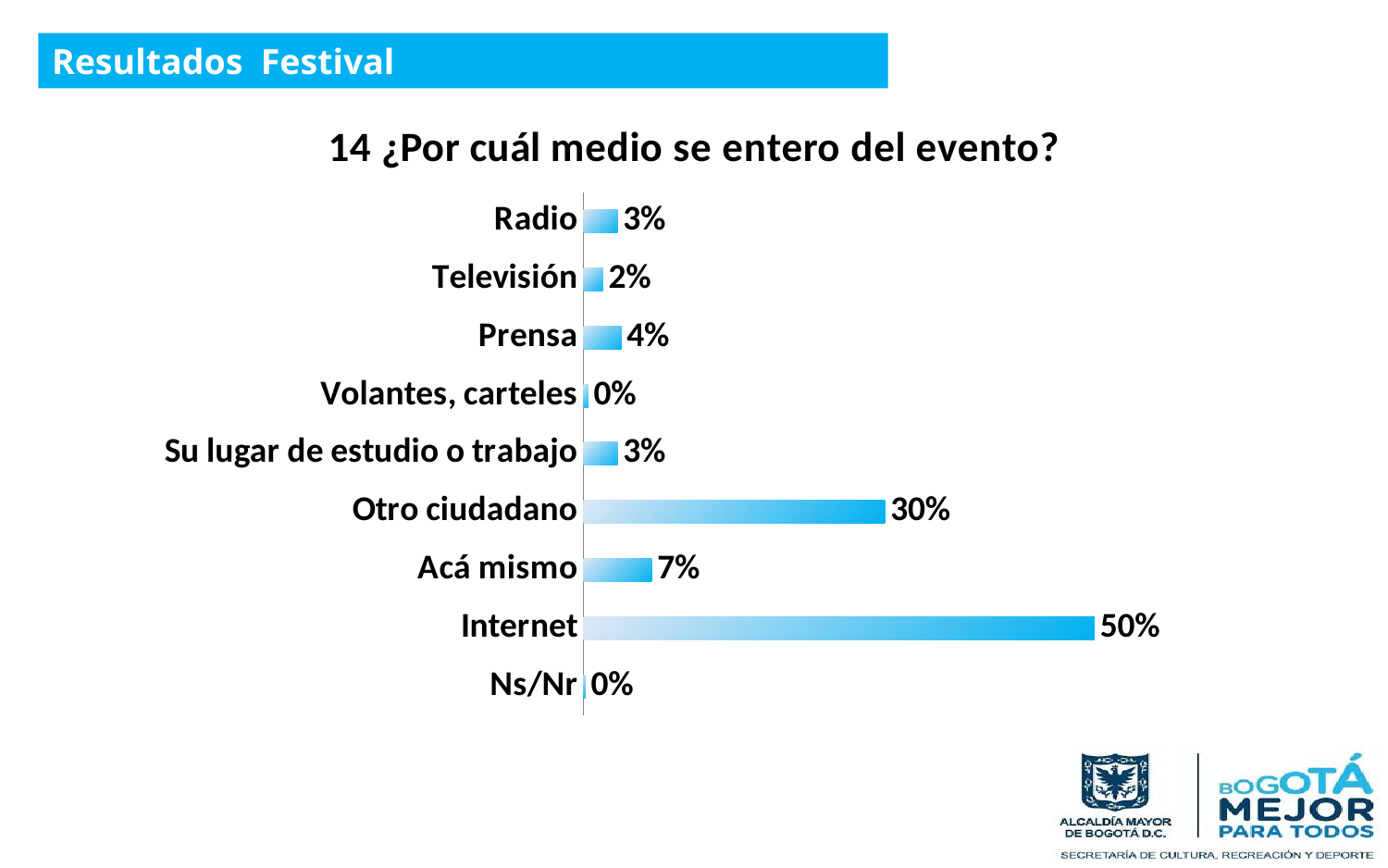
Which is larger, the value for Acá mismo or the value for Prensa? Acá mismo How many categories are shown in the chart? 9 What kind of chart is shown on the slide? Bar chart What is the value for Prensa? 4% What is the title of the chart? 14 ¿Por cuál medio se entero del evento? What is the value for Acá mismo? 7% Which category has the highest value? Internet Which categories have a value of 0%? Volantes, carteles and Ns/Nr What is the value for Internet? 50% What is the difference between the values for Radio and Televisión? 1% What is the value for Otro ciudadano? 30% What is the difference between the values for Internet and Otro ciudadano? 20%